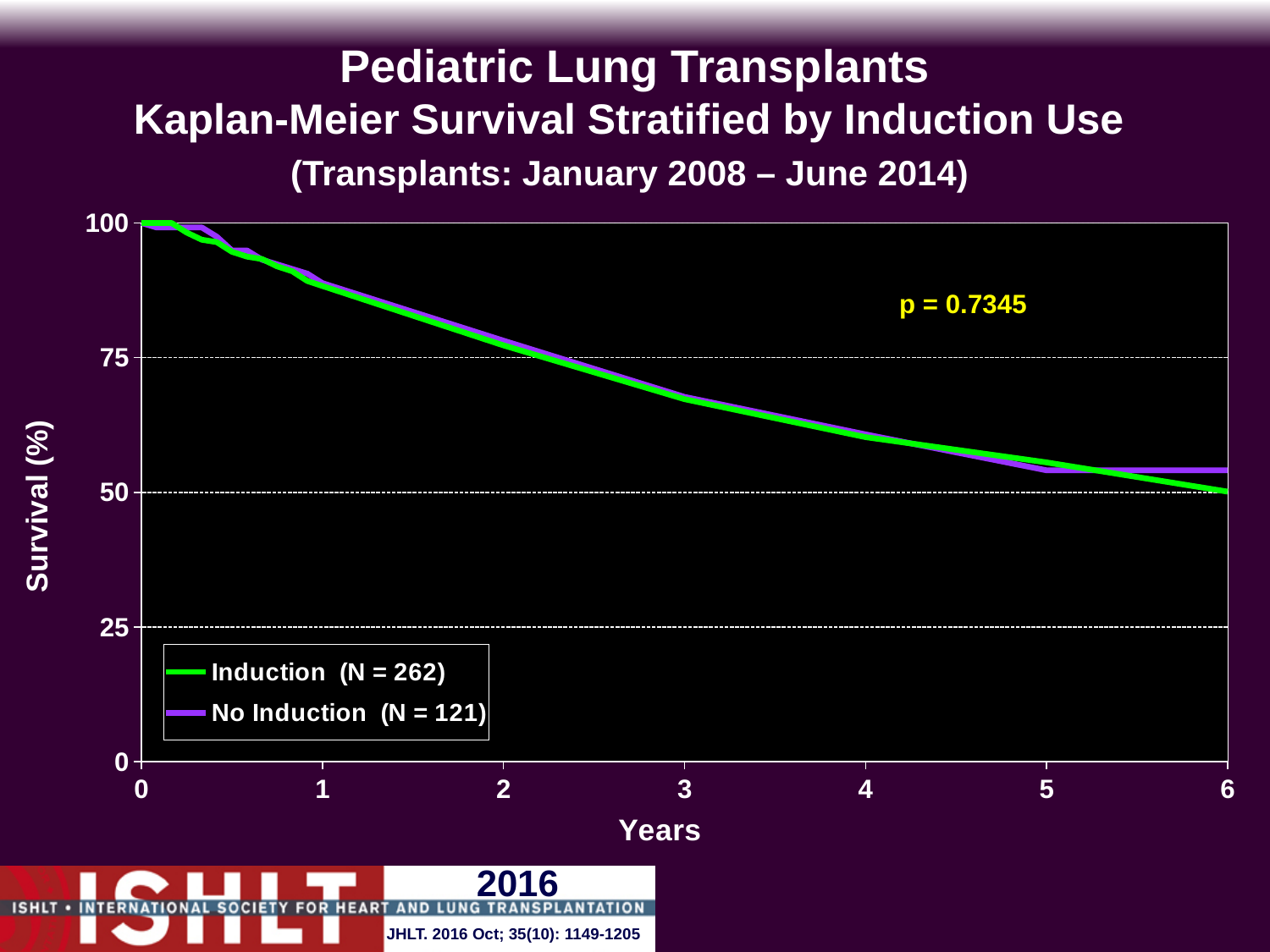
What colour is the line for the No Induction group? Purple Is the survival value for the No Induction group at 1 year greater or less than 75? greater What p-value is shown on the chart? p = 0.7345 Is the survival value for the Induction group at 5 years greater or less than 50? greater Which group has the larger N, Induction or No Induction? Induction Do the survival curves rise or fall as years increase? Fall How many series does the legend list? 2 What is the N value for the Induction group shown in the legend? 262 What is the N value for the No Induction group shown in the legend? 121 What is the difference between the N values of the Induction and No Induction groups? 141 Is the survival value for the Induction group at 3 years greater or less than 75? less What kind of chart is shown on the slide? Line chart